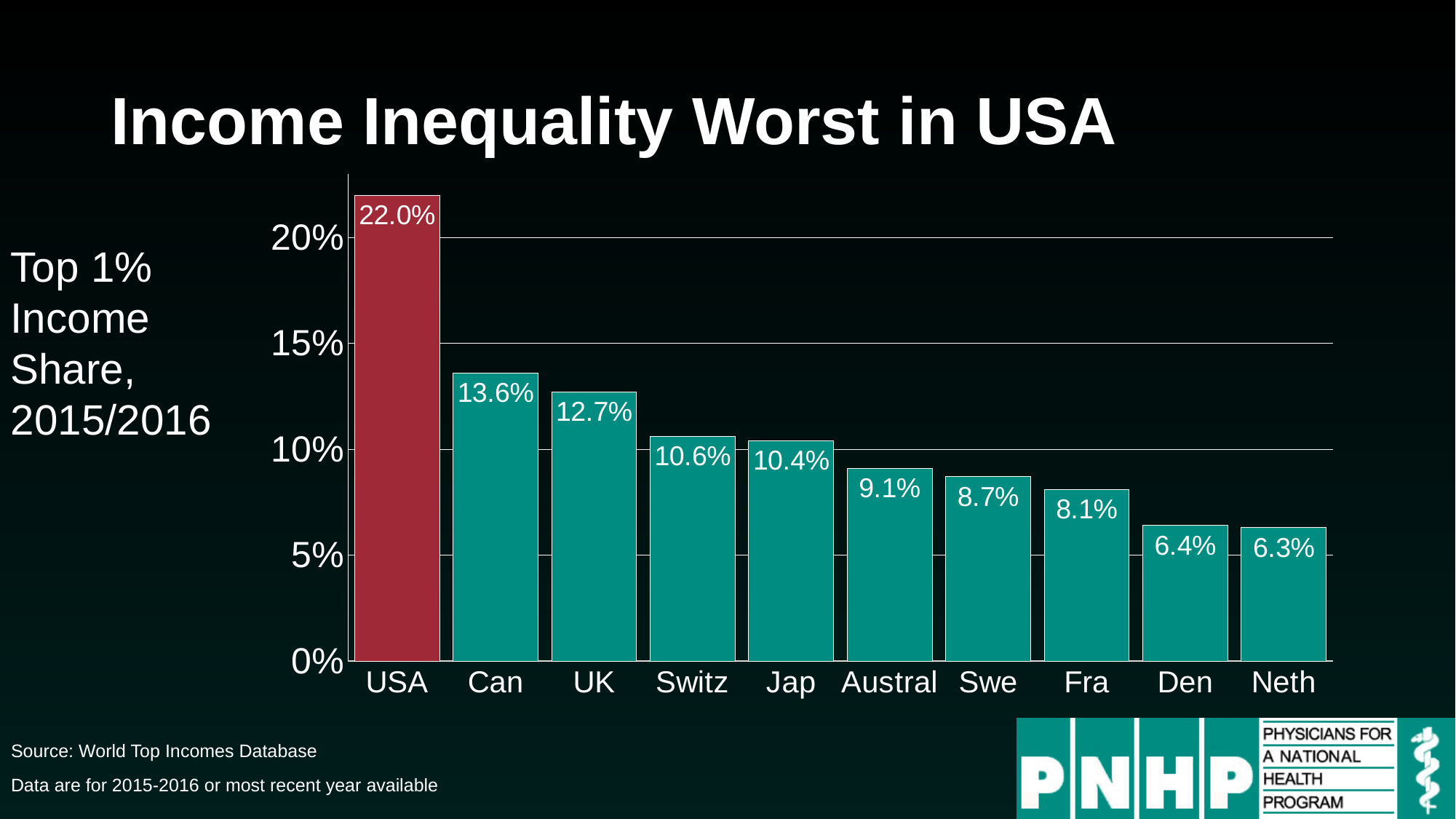
What is the top 1% income share shown for the USA? 22.0% Which bar is coloured differently from the others? USA What kind of chart is shown on the slide? Bar chart What is the difference between the values for USA and Can? 8.4% Which has a larger value, Switz or Austral? Switz What is the difference between the values for UK and Fra? 4.6% Which country has the lowest value on the chart? Neth What is the value shown for Swe? 8.7% What is the value shown for Can? 13.6% Which country has the highest top 1% income share on the chart? USA How many countries are shown on the chart? 10 Do the values rise or fall moving from left to right across the chart? Fall